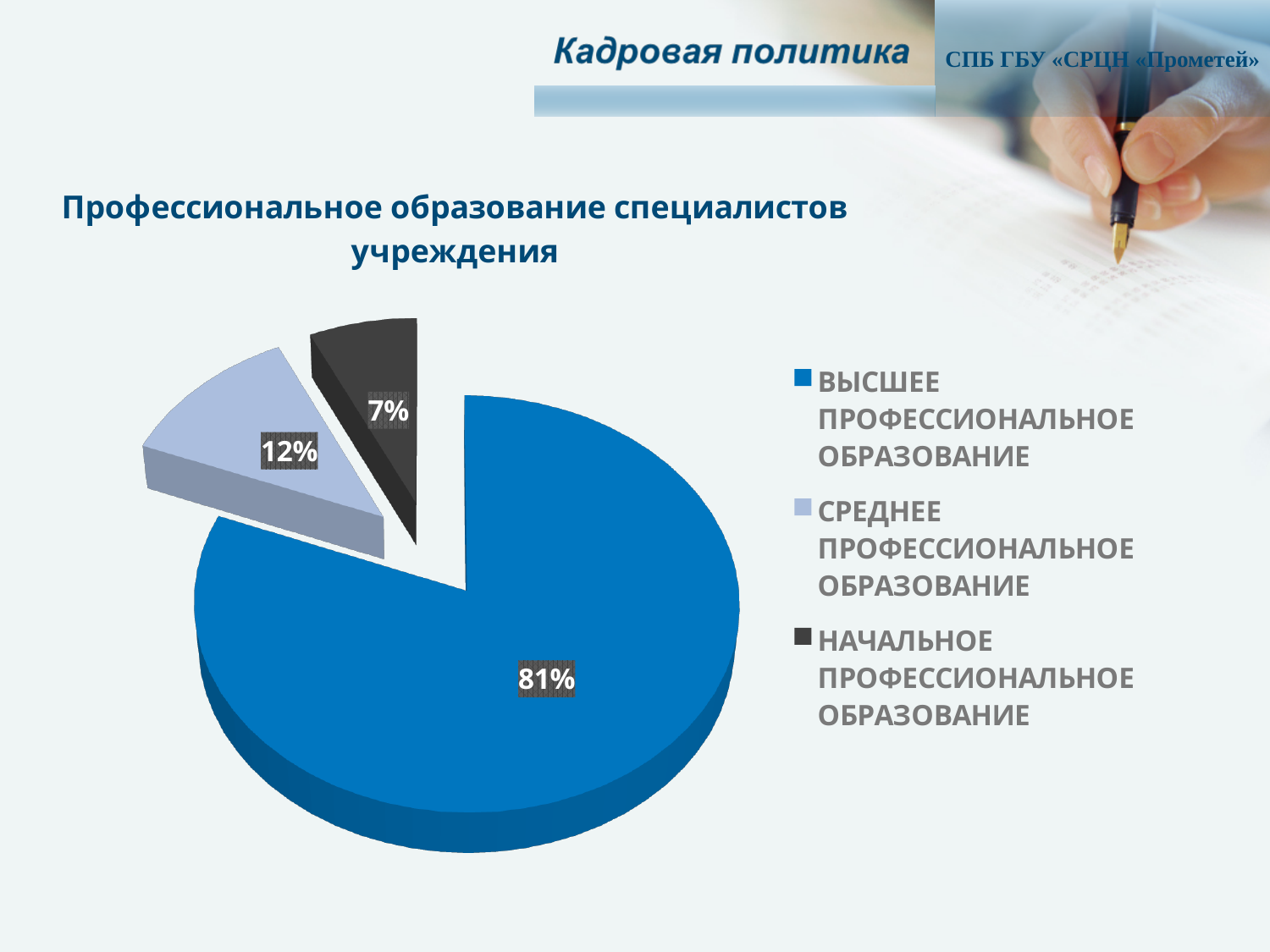
What is the title of the chart? Профессиональное образование специалистов учреждения What is the difference in percentage points between the ВЫСШЕЕ and СРЕДНЕЕ ПРОФЕССИОНАЛЬНОЕ ОБРАЗОВАНИЕ slices? 69 percentage points What is the difference in percentage points between the СРЕДНЕЕ and НАЧАЛЬНОЕ ПРОФЕССИОНАЛЬНОЕ ОБРАЗОВАНИЕ slices? 5 percentage points What colour is the slice for НАЧАЛЬНОЕ ПРОФЕССИОНАЛЬНОЕ ОБРАЗОВАНИЕ? Dark grey (black) Which category has the smallest slice of the pie? НАЧАЛЬНОЕ ПРОФЕССИОНАЛЬНОЕ ОБРАЗОВАНИЕ Which is larger: the slice for СРЕДНЕЕ ПРОФЕССИОНАЛЬНОЕ ОБРАЗОВАНИЕ or НАЧАЛЬНОЕ ПРОФЕССИОНАЛЬНОЕ ОБРАЗОВАНИЕ? СРЕДНЕЕ ПРОФЕССИОНАЛЬНОЕ ОБРАЗОВАНИЕ Which category has the largest slice of the pie? ВЫСШЕЕ ПРОФЕССИОНАЛЬНОЕ ОБРАЗОВАНИЕ What share of the pie does ВЫСШЕЕ ПРОФЕССИОНАЛЬНОЕ ОБРАЗОВАНИЕ have? 81% What share of the pie does СРЕДНЕЕ ПРОФЕССИОНАЛЬНОЕ ОБРАЗОВАНИЕ have? 12% What kind of chart is shown on the slide? Pie chart How many categories does the pie chart show? 3 What share of the pie does НАЧАЛЬНОЕ ПРОФЕССИОНАЛЬНОЕ ОБРАЗОВАНИЕ have? 7%